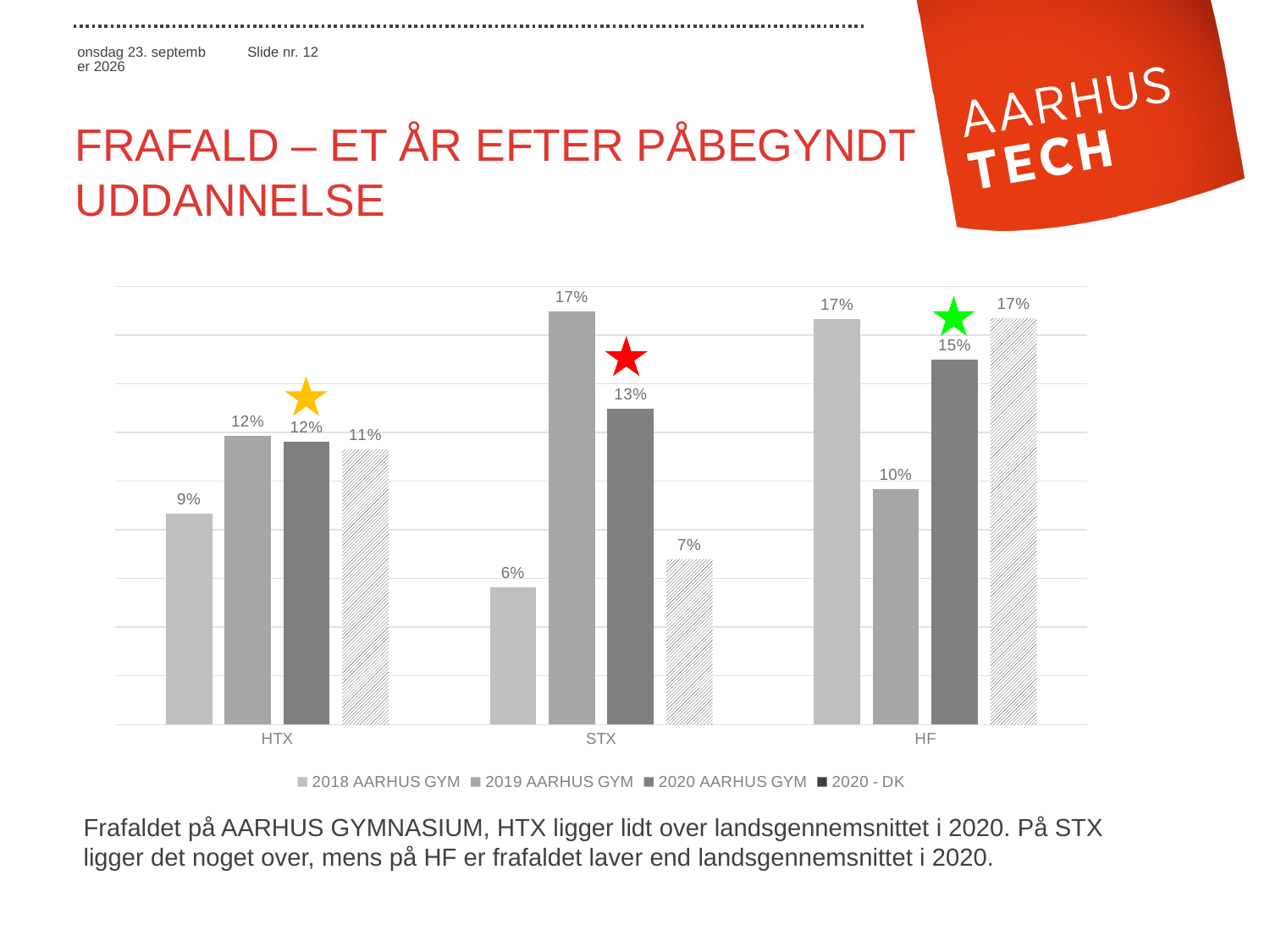
Which series is drawn with a hatched pattern? 2020 - DK How many series does the legend list? 4 What is the value for 2020 - DK in the STX category? 7% Which is larger for HF: the 2020 AARHUS GYM value or the 2020 - DK value? 2020 - DK What is the value for 2018 AARHUS GYM in the HTX category? 9% Which category has the lowest value for 2018 AARHUS GYM? STX What kind of chart is shown on the slide? Bar chart What is the value for 2020 AARHUS GYM in the HF category? 15% What is the difference between the 2020 AARHUS GYM value and the 2020 - DK value for STX? 6% How many categories are shown on the x axis? 3 What is the value for 2019 AARHUS GYM in the STX category? 17% Which category has the highest value for 2020 AARHUS GYM? HF